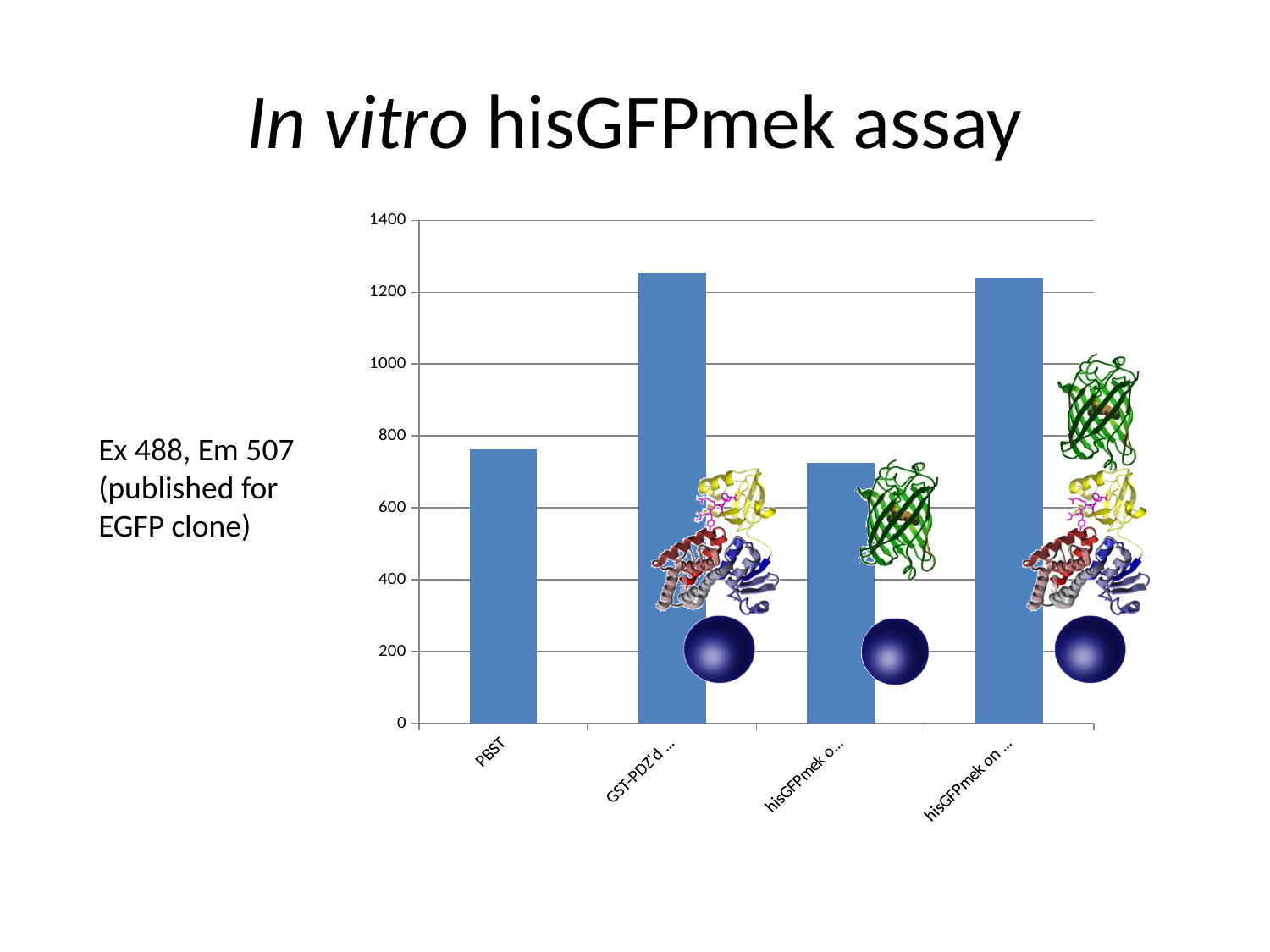
Is the value of the rightmost bar (hisGFPmek on ...) greater or less than 1000? greater Is the value of the second bar from the left (GST-PDZ'd ...) greater or less than 1200? greater What kind of chart is shown on the slide? bar chart How many bars (categories) does the chart show? 4 Is the value of the third bar from the left (hisGFPmek o...) greater or less than 600? greater What is the title of the slide containing the chart? In vitro hisGFPmek assay What is the maximum value shown on the vertical axis of the chart? 1400 Which is larger, the value of the third bar from the left (hisGFPmek o...) or the rightmost bar (hisGFPmek on ...)? hisGFPmek on ... Which is larger, the value for PBST or the value of the second bar from the left (GST-PDZ'd ...)? GST-PDZ'd ...